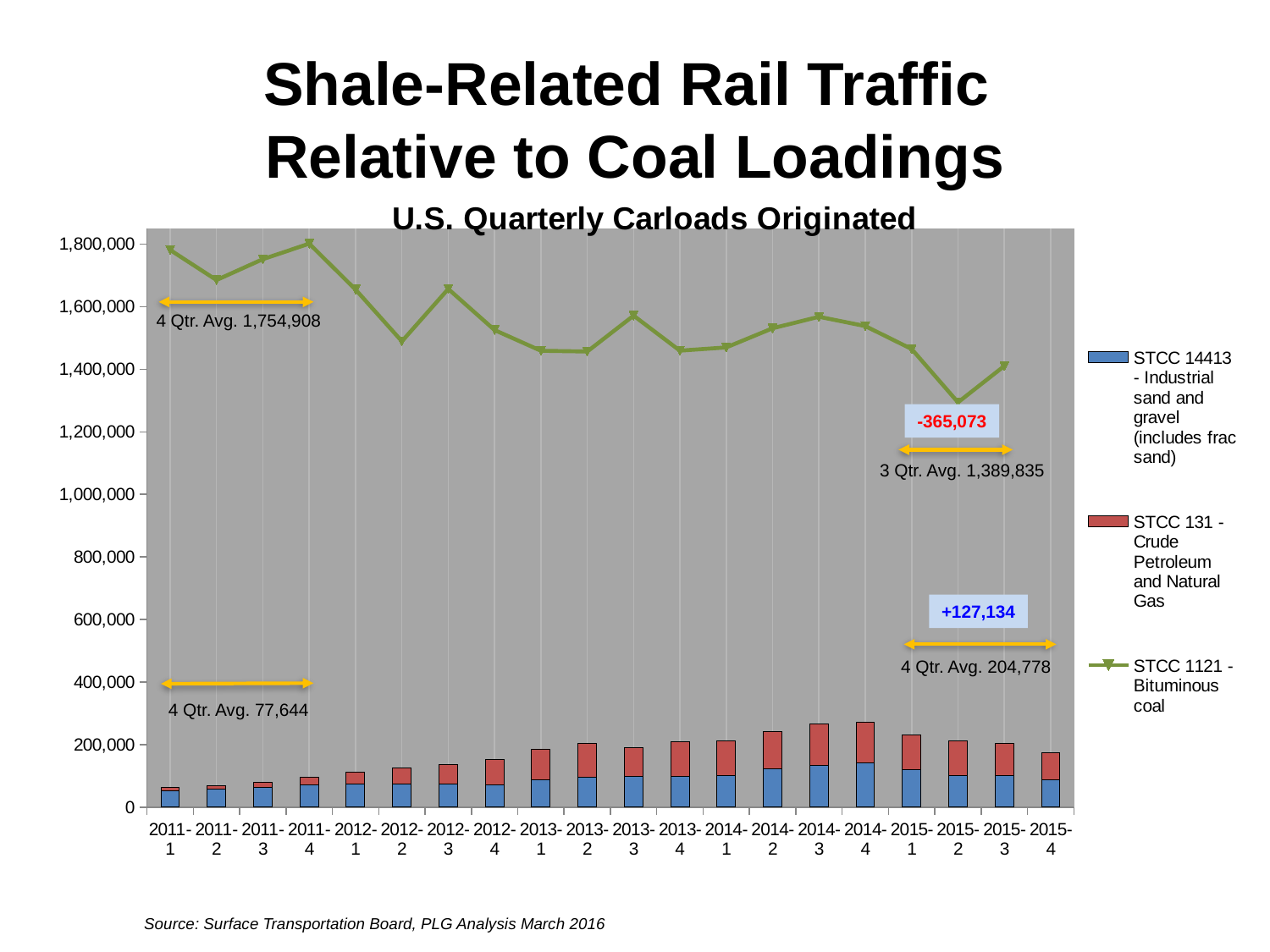
What is the 4 Qtr. Avg. annotated for bituminous coal at the start of the period (2011)? 1,754,908 What kind of chart is shown on the slide? A combination chart with stacked bars and a line In which quarter is the bituminous coal line at its lowest? 2015-2 How many quarters are shown along the x axis? 20 What change in shale-related carloads is annotated between the 2011 and 2015 averages? +127,134 What is the 3 Qtr. Avg. annotated for bituminous coal at the end of the period (2015)? 1,389,835 Is the bituminous coal value for 2015-2 greater or less than 1,400,000? less What is the 4 Qtr. Avg. annotated for the shale-related carloads in 2011? 77,644 Does the bituminous coal line generally rise or fall from 2011-1 to 2015-4? Fall What change in bituminous coal carloads is annotated between the early and late averages? -365,073 Which series is plotted as a line rather than bars? STCC 1121 - Bituminous coal How many series does the legend list? 3